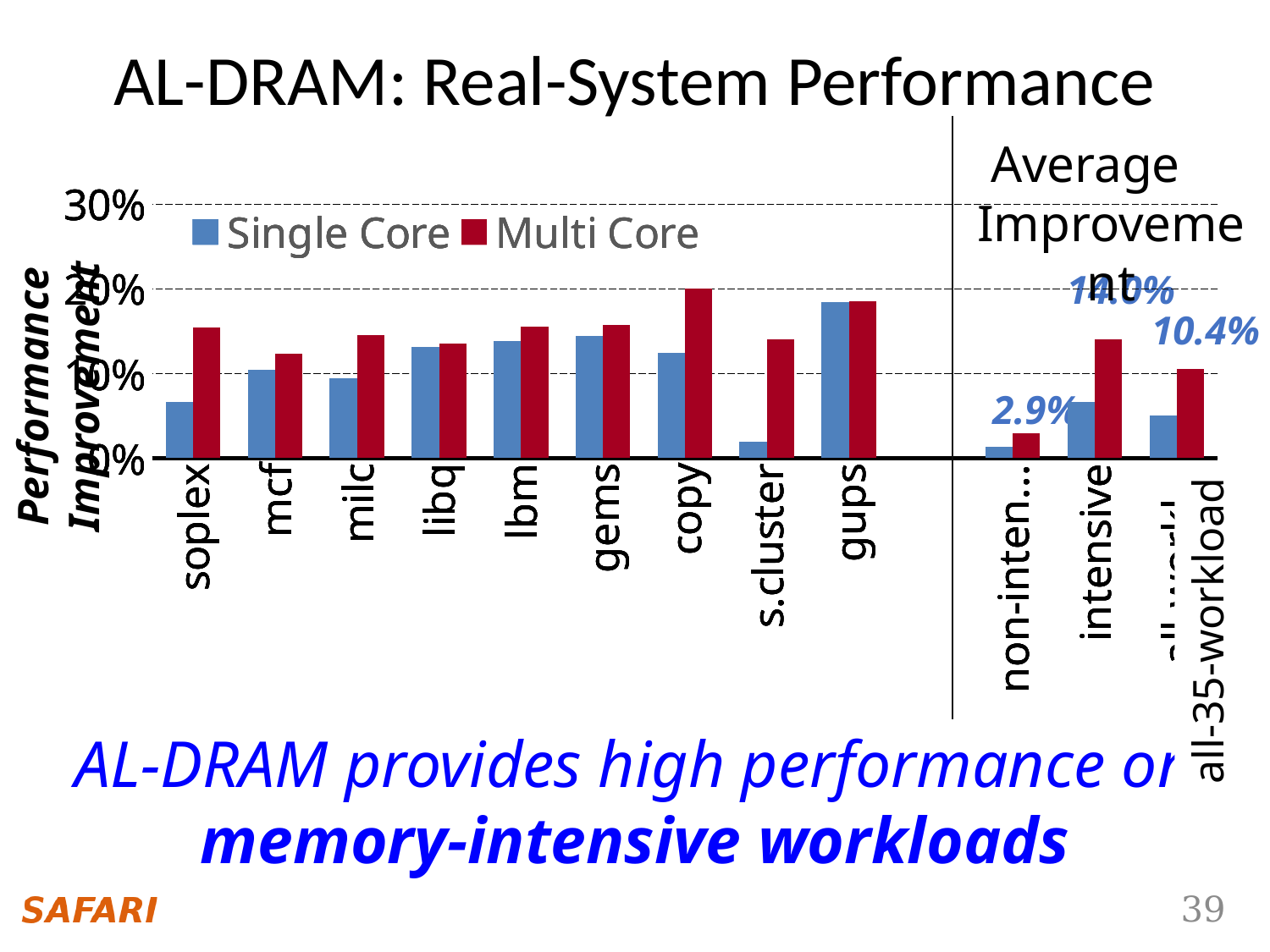
What is the title of the slide containing the chart? AL-DRAM: Real-System Performance Which workload has the highest Single Core performance improvement? gups For soplex, which is larger: the Single Core or the Multi Core value? Multi Core Is the Single Core value for gups greater or less than 20%? less What kind of chart is shown on the slide? bar chart What are the two series named in the legend? Single Core and Multi Core What is the Multi Core value labelled for the non-intensive category? 2.9% Among the workloads left of the vertical divider line, which has the lowest Single Core performance improvement? s.cluster What is the Multi Core value labelled for the all-35-workload category? 10.4% How many series does the legend list? 2 Is the Single Core value for soplex greater or less than 10%? less Which workload has the highest Multi Core performance improvement? copy